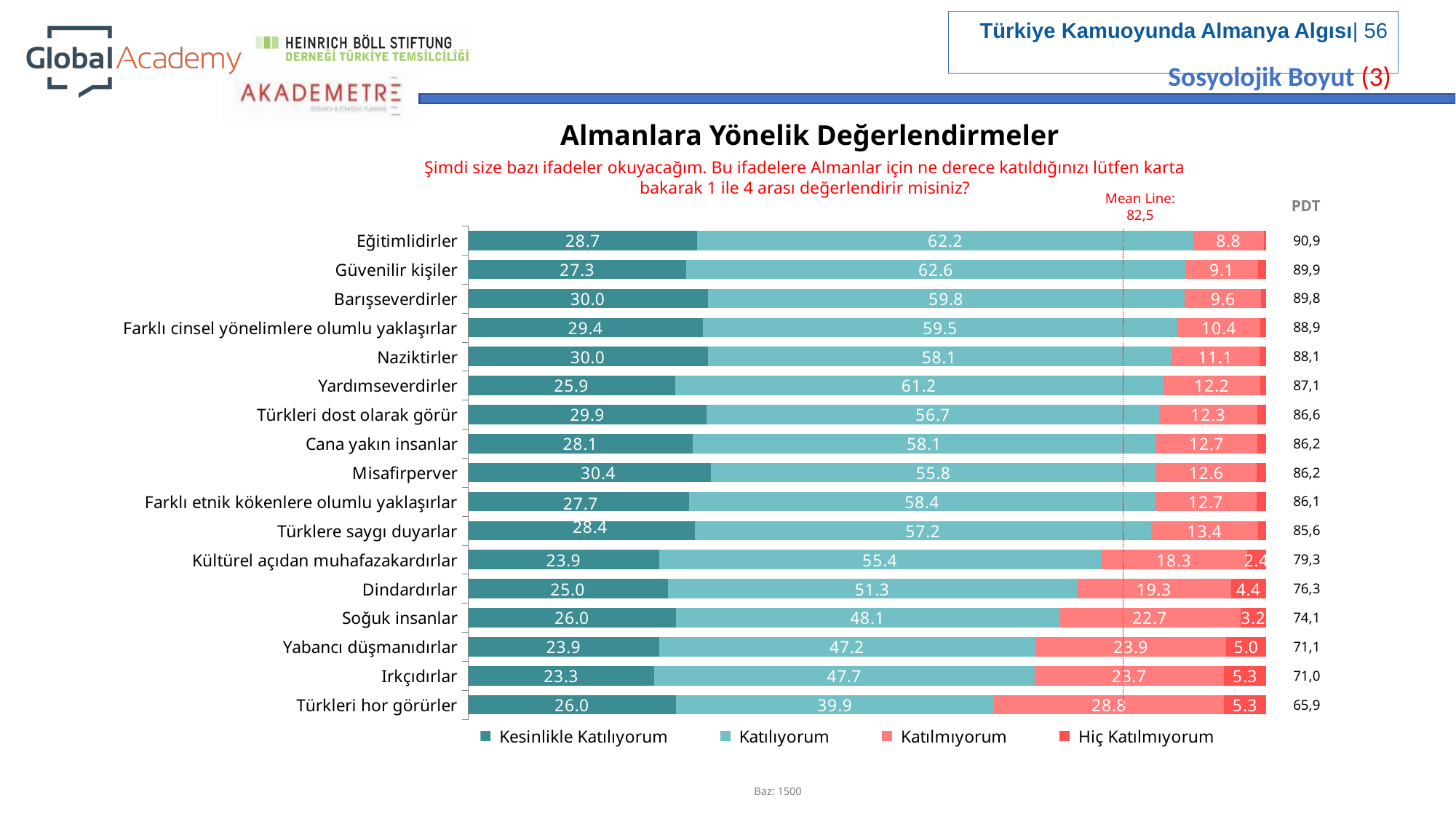
What is the value of Kesinlikle Katılıyorum for Eğitimlidirler? 28.7 Which statement has the lowest Katılıyorum value? Türkleri hor görürler What is the value of Katılmıyorum for Dindardırlar? 19.3 How many series does the legend list? 4 What value is shown for the Mean Line? 82,5 What kind of chart is shown on the slide? Stacked bar chart How many statements (categories) are plotted in the chart? 17 Which statement has the highest Katılıyorum value? Güvenilir kişiler What is the difference between the Katılmıyorum values for Türkleri hor görürler and Eğitimlidirler? 20.0 What is the value of Hiç Katılmıyorum for Irkçıdırlar? 5.3 What is the PDT value shown for Eğitimlidirler? 90,9 What is the value of Katılıyorum for Türkleri hor görürler? 39.9